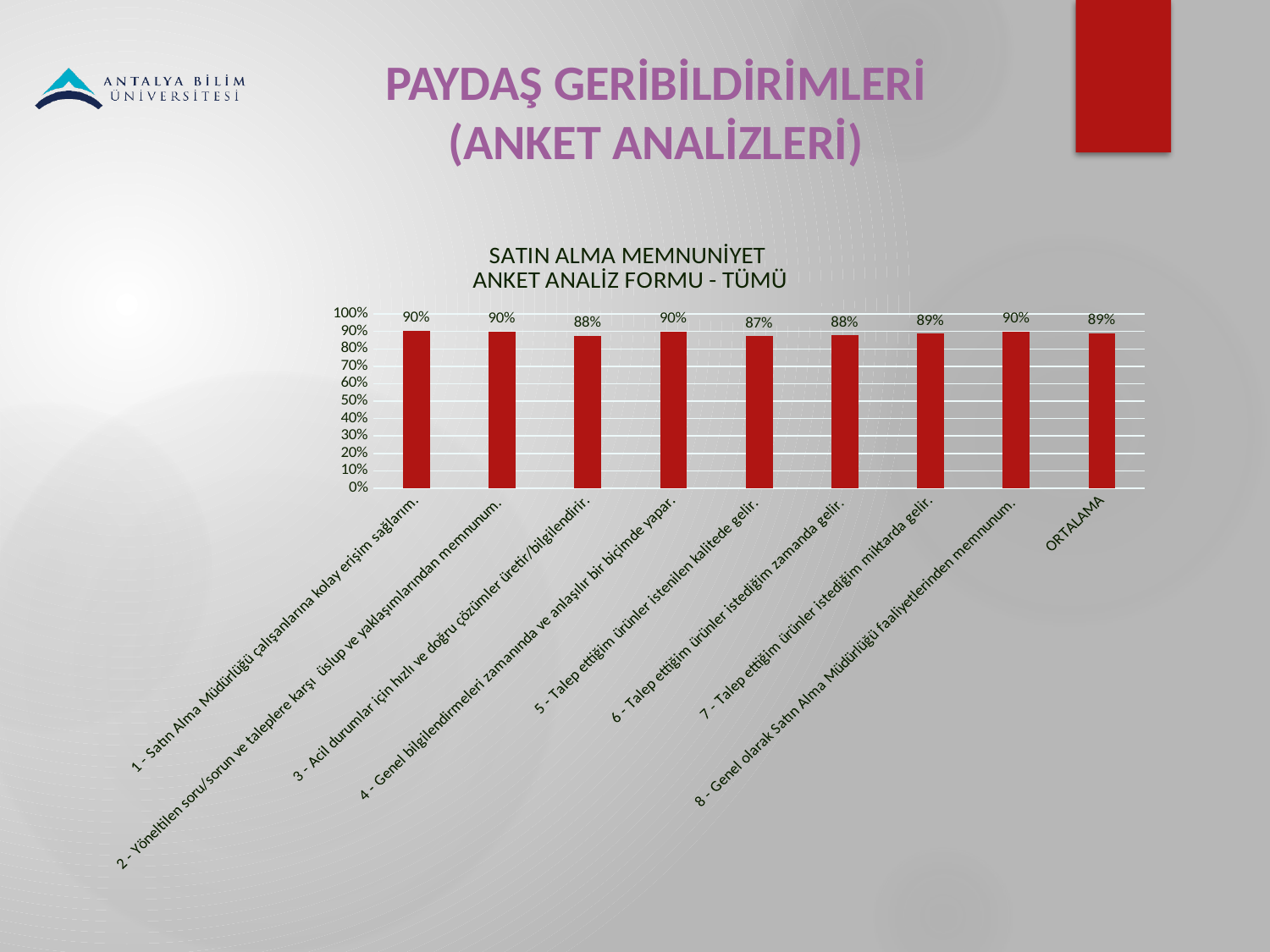
How many bars are shown on the chart? 9 What is the value for "7 - Talep ettiğim ürünler istediğim miktarda gelir."? 89% What is the difference between the value for item 1 (Satın Alma Müdürlüğü çalışanlarına kolay erişim sağlarım.) and item 5 (Talep ettiğim ürünler istenilen kalitede gelir.)? 3 percentage points What is the value for "3 - Acil durumlar için hızlı ve doğru çözümler üretir/bilgilendirir."? 88% What is the value for ORTALAMA? 89% Which is larger: the value for item 2 (Yöneltilen soru/sorun ve taleplere karşı üslup ve yaklaşımlarından memnunum.) or item 6 (Talep ettiğim ürünler istediğim zamanda gelir.)? Item 2 Which category has the lowest value? 5 - Talep ettiğim ürünler istenilen kalitede gelir. What kind of chart is shown on the slide? Bar chart What is the title of the chart? SATIN ALMA MEMNUNİYET ANKET ANALİZ FORMU - TÜMÜ What is the value for "8 - Genel olarak Satın Alma Müdürlüğü faaliyetlerinden memnunum."? 90% What is the highest value shown on the chart? 90% What is the value for "5 - Talep ettiğim ürünler istenilen kalitede gelir."? 87%